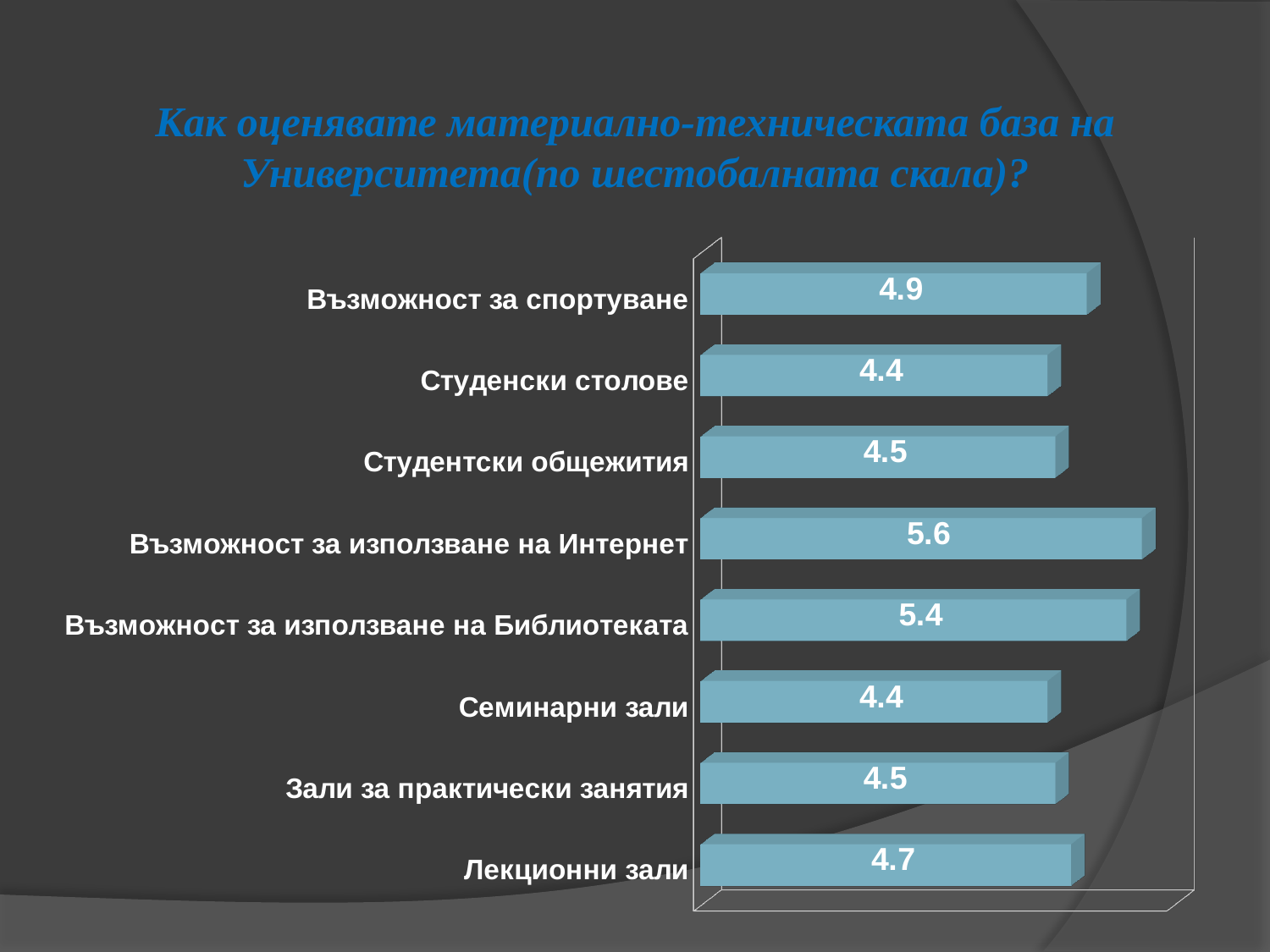
What is the value for Студентски общежития? 4.5 What is the value for Лекционни зали? 4.7 What is the difference between the values for Възможност за използване на Библиотеката and Зали за практически занятия? 0.9 What kind of chart is shown on the slide? Bar chart Which is larger, the value for Възможност за спортуване or the value for Лекционни зали? Възможност за спортуване What is the lowest value shown in the chart? 4.4 What is the difference between the values for Възможност за използване на Интернет and Семинарни зали? 1.2 What is the value for Възможност за използване на Библиотеката? 5.4 What is the value for Възможност за използване на Интернет? 5.6 How many categories are shown in the chart? 8 What is the value for Възможност за спортуване? 4.9 Which category has the highest value? Възможност за използване на Интернет